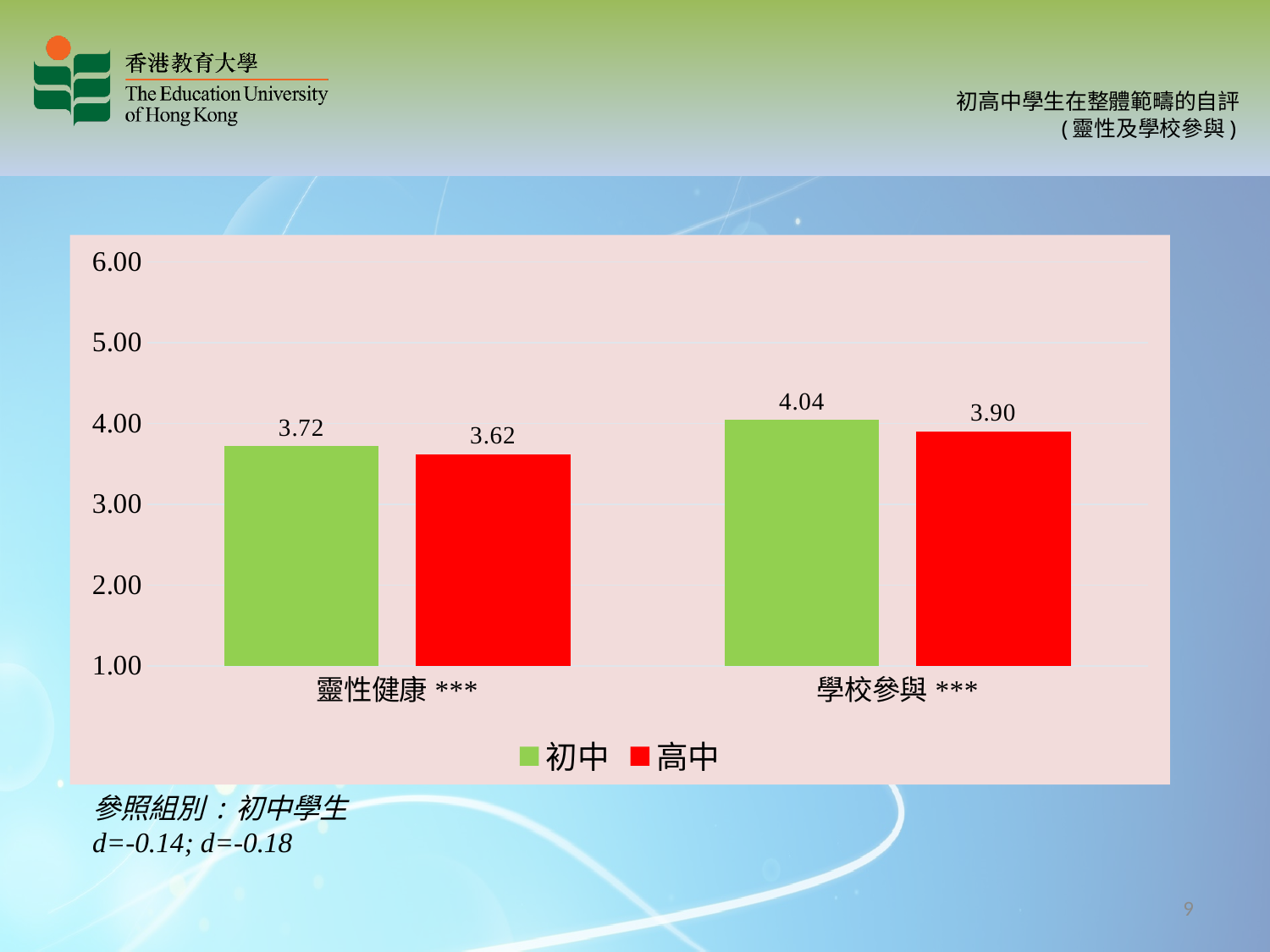
What is the value for 高中 in the 靈性健康 *** category? 3.62 What is the value for 初中 in the 靈性健康 *** category? 3.72 Is the value for 初中 in the 學校參與 *** category greater or less than 4.00? greater What kind of chart is shown on the slide? bar chart What is the difference between the 初中 and 高中 values in the 學校參與 *** category? 0.14 How many series does the legend list? 2 In the 靈性健康 *** category, which series has the larger value, 初中 or 高中? 初中 What is the value for 高中 in the 學校參與 *** category? 3.90 Which category has the lowest value for 高中? 靈性健康 *** Which category has the highest value for 初中? 學校參與 *** How many categories are shown on the x axis? 2 What is the difference between the 初中 and 高中 values in the 靈性健康 *** category? 0.10